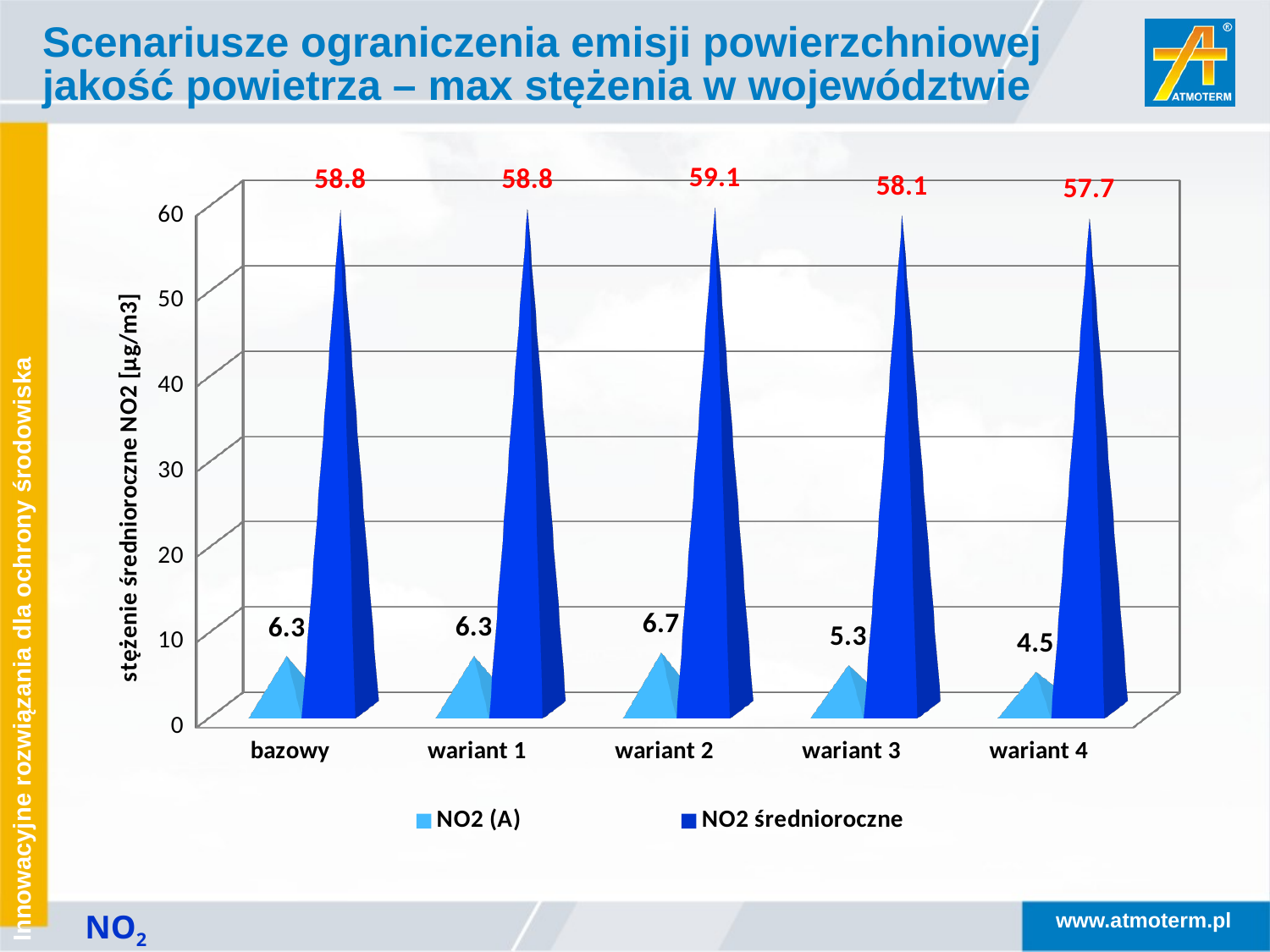
How many series does the legend list? 2 What is the y-axis label of the chart? stężenie średnioroczne NO2 [µg/m3] What is the difference between the NO2 średnioroczne values for bazowy and wariant 4? 1.1 What is the value of NO2 (A) for wariant 2? 6.7 Which category has the highest NO2 średnioroczne value? wariant 2 What is the difference between the NO2 (A) values for wariant 2 and wariant 4? 2.2 What is the value of NO2 (A) for wariant 3? 5.3 What is the value of NO2 średnioroczne for bazowy? 58.8 Which is larger: the NO2 (A) value for bazowy or for wariant 3? bazowy What is the value of NO2 średnioroczne for wariant 4? 57.7 How many categories are shown on the x axis? 5 Which category has the lowest NO2 (A) value? wariant 4